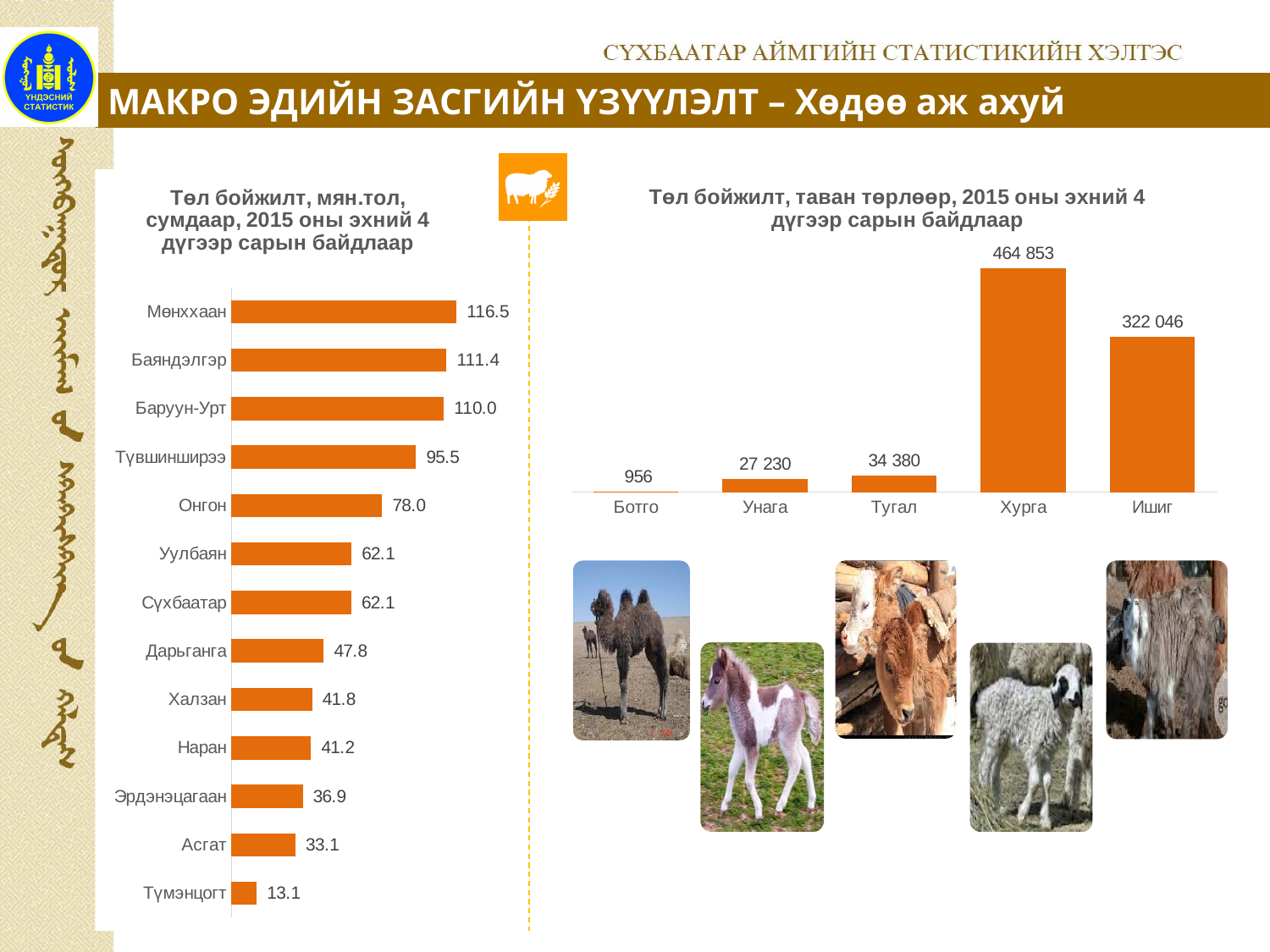
In the left chart, what is the difference between the values for Мөнххаан and Баяндэлгэр? 5.1 How many categories are shown in the left chart? 13 In the left chart, which category has the lowest value? Түмэнцогт In the right chart, what is the value for Ботго? 956 In the left chart, which is larger, the value for Онгон or the value for Дарьганга? Онгон What kind of chart is the left chart? Bar chart In the right chart, what is the value for Хурга? 464 853 How many categories are shown in the right chart? 5 In the right chart, what is the difference between the values for Хурга and Ишиг? 142 807 In the right chart, which category has the highest value? Хурга In the left chart, what is the value for Мөнххаан? 116.5 In the left chart, what is the value for Түмэнцогт? 13.1